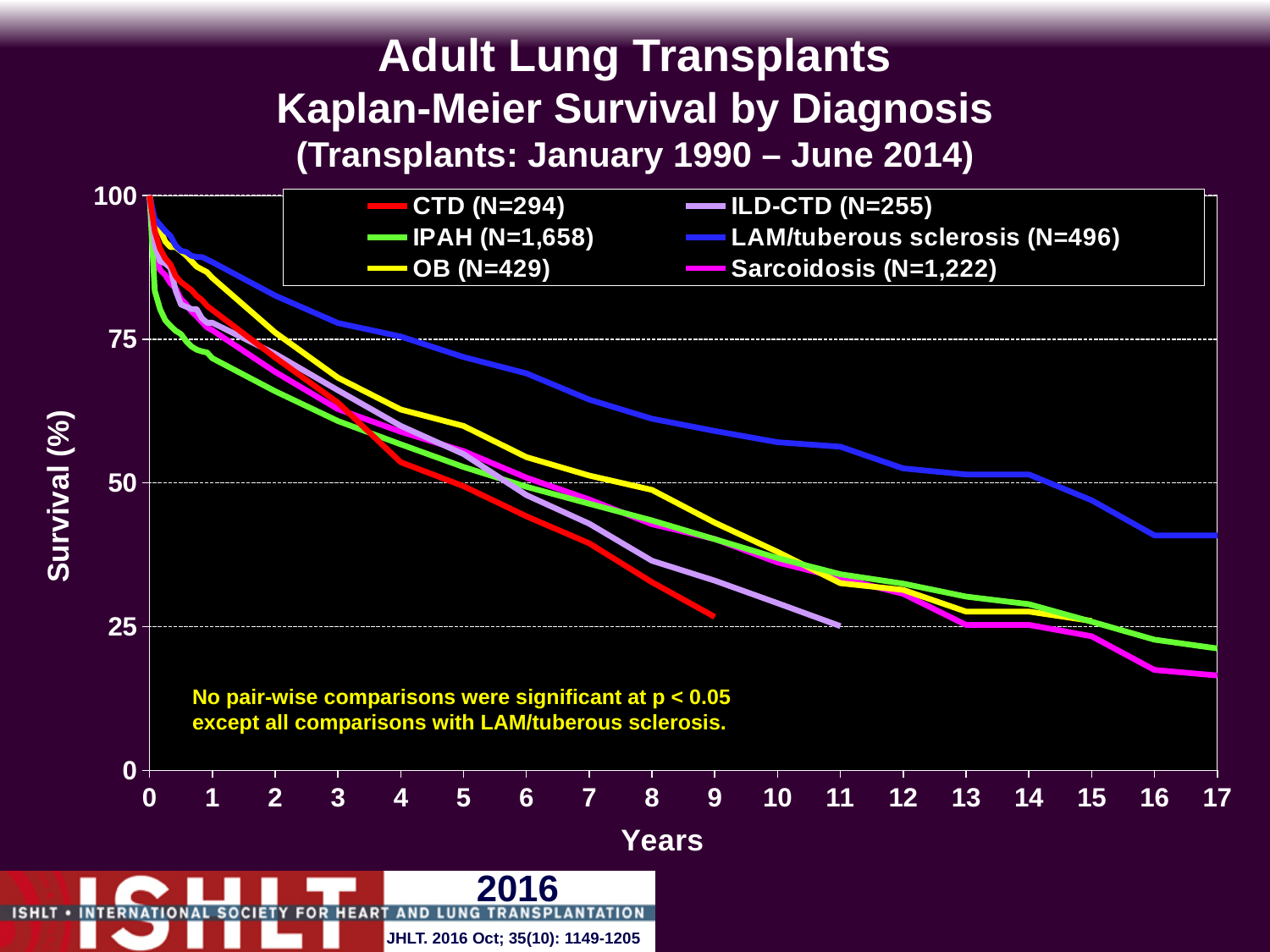
At 8 years, which has higher survival, CTD or LAM/tuberous sclerosis? LAM/tuberous sclerosis Do the survival curves rise or fall as years increase? Fall Is the survival for OB at 5 years greater or less than 50%? greater Is the survival for Sarcoidosis at 17 years greater or less than 25%? less At 3 years, which has higher survival, OB or IPAH? OB Which diagnosis group has the lowest survival at 8 years? CTD Which diagnosis group has the lowest survival at 17 years? Sarcoidosis What kind of chart is shown on the slide? Line chart According to the legend, how many transplants are in the IPAH group? N=1,658 How many diagnosis groups does the legend list? 6 Which diagnosis group has the highest survival at 10 years? LAM/tuberous sclerosis Is the survival for LAM/tuberous sclerosis at 10 years greater or less than 50%? greater